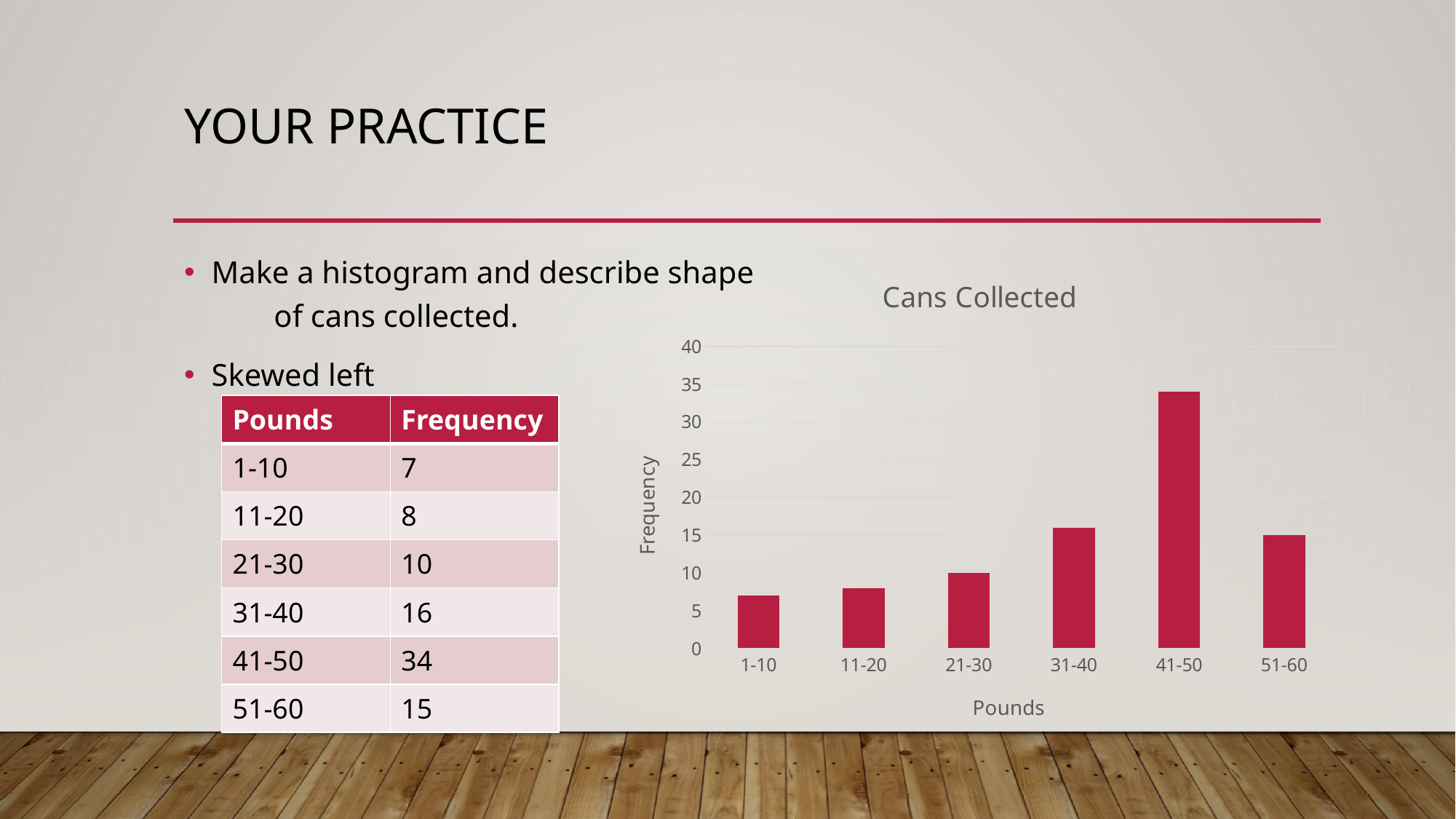
What is the frequency for the 21-30 pounds category? 10 What is the frequency for the 51-60 pounds category? 15 What type of chart is shown on the slide? bar chart What is the frequency for the 41-50 pounds category? 34 Which has a higher frequency, 31-40 pounds or 51-60 pounds? 31-40 Is the frequency for the 1-10 pounds category greater or less than 10? less What is the title of the chart? Cans Collected Is the frequency for the 31-40 pounds category greater or less than 15? greater How many categories are shown on the x axis of the chart? 6 Which pounds category has the highest frequency in the chart? 41-50 Which pounds category has the lowest frequency in the chart? 1-10 What is the difference in frequency between the 41-50 and 51-60 pounds categories? 19